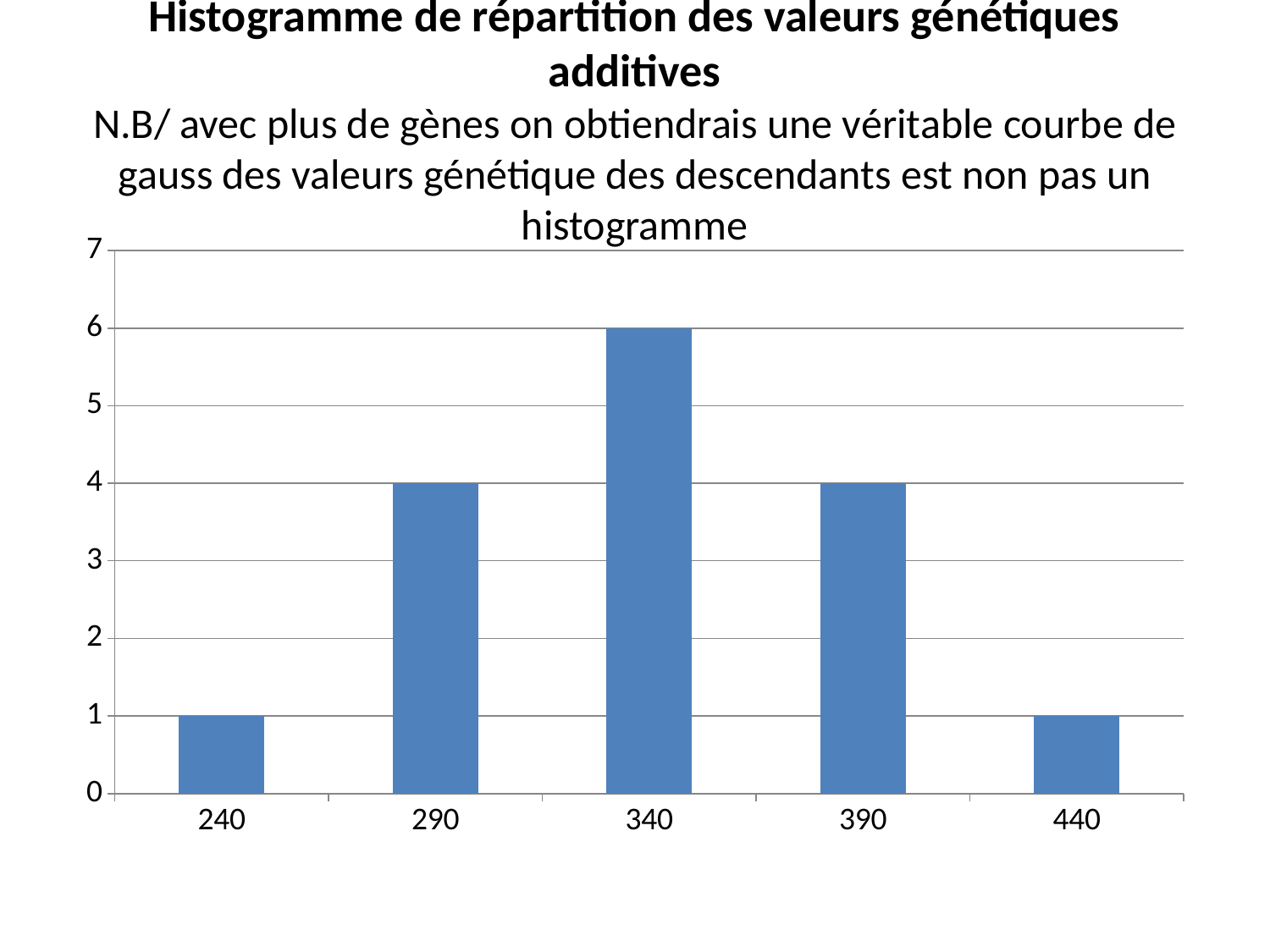
Do the values rise or fall from category 340 to category 440? fall What is the value for category 440? 1 Which is larger, the value for 290 or the value for 440? 290 Is the value for 240 greater or less than 2? less What is the value for category 290? 4 What is the value for category 340? 6 What kind of chart is shown on the slide? bar chart How many categories are shown on the x axis? 5 What is the difference between the values for 290 and 240? 3 Which category has the highest value? 340 What is the difference between the values for 340 and 390? 2 Is the value for 340 greater or less than 5? greater